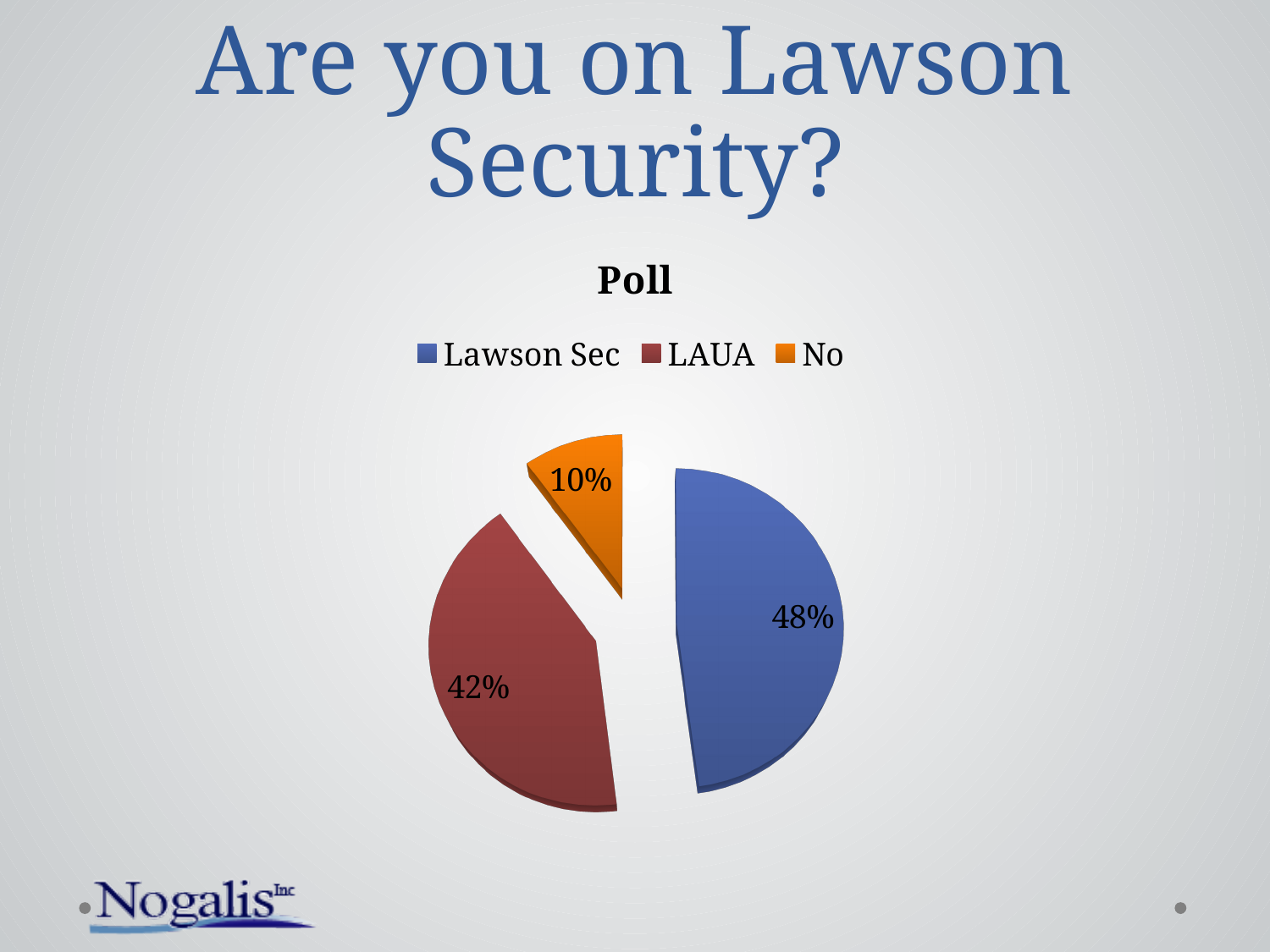
What colour is the slice for No? orange Which category has the smallest slice of the pie? No How many categories does the pie chart have? 3 What kind of chart is shown on the slide? pie chart Which is larger, the share for LAUA or the share for No? LAUA What is the difference in percentage points between LAUA and No? 32% What is the chart's title? Poll What share of the pie does Lawson Sec have? 48% What is the difference in percentage points between Lawson Sec and LAUA? 6% What share of the pie does No have? 10% What share of the pie does LAUA have? 42% Which category has the largest slice of the pie? Lawson Sec